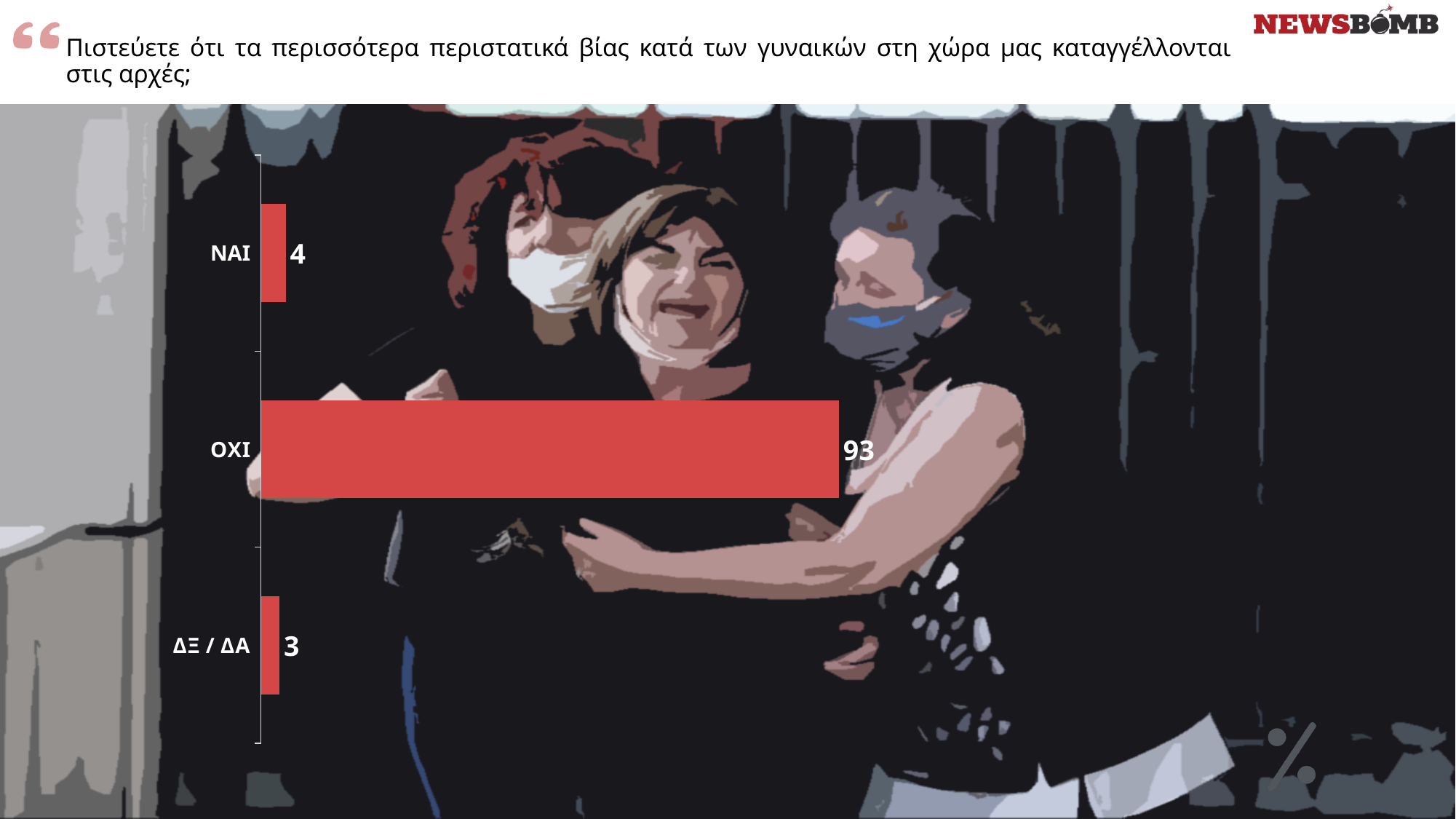
What is the value for ΟΧΙ? 93 What is the difference between the values for ΝΑΙ and ΔΞ / ΔΑ? 1 How many categories are shown in the chart? 3 What kind of chart is shown on the slide? bar chart Which category has the highest value? ΟΧΙ What is the total of the three values shown in the chart? 100 Which is larger, the value for ΝΑΙ or the value for ΟΧΙ? ΟΧΙ What is the difference between the values for ΟΧΙ and ΝΑΙ? 89 What is the value for ΝΑΙ? 4 What is the value for ΔΞ / ΔΑ? 3 Which category has the lowest value? ΔΞ / ΔΑ What colour are the bars in the chart? red